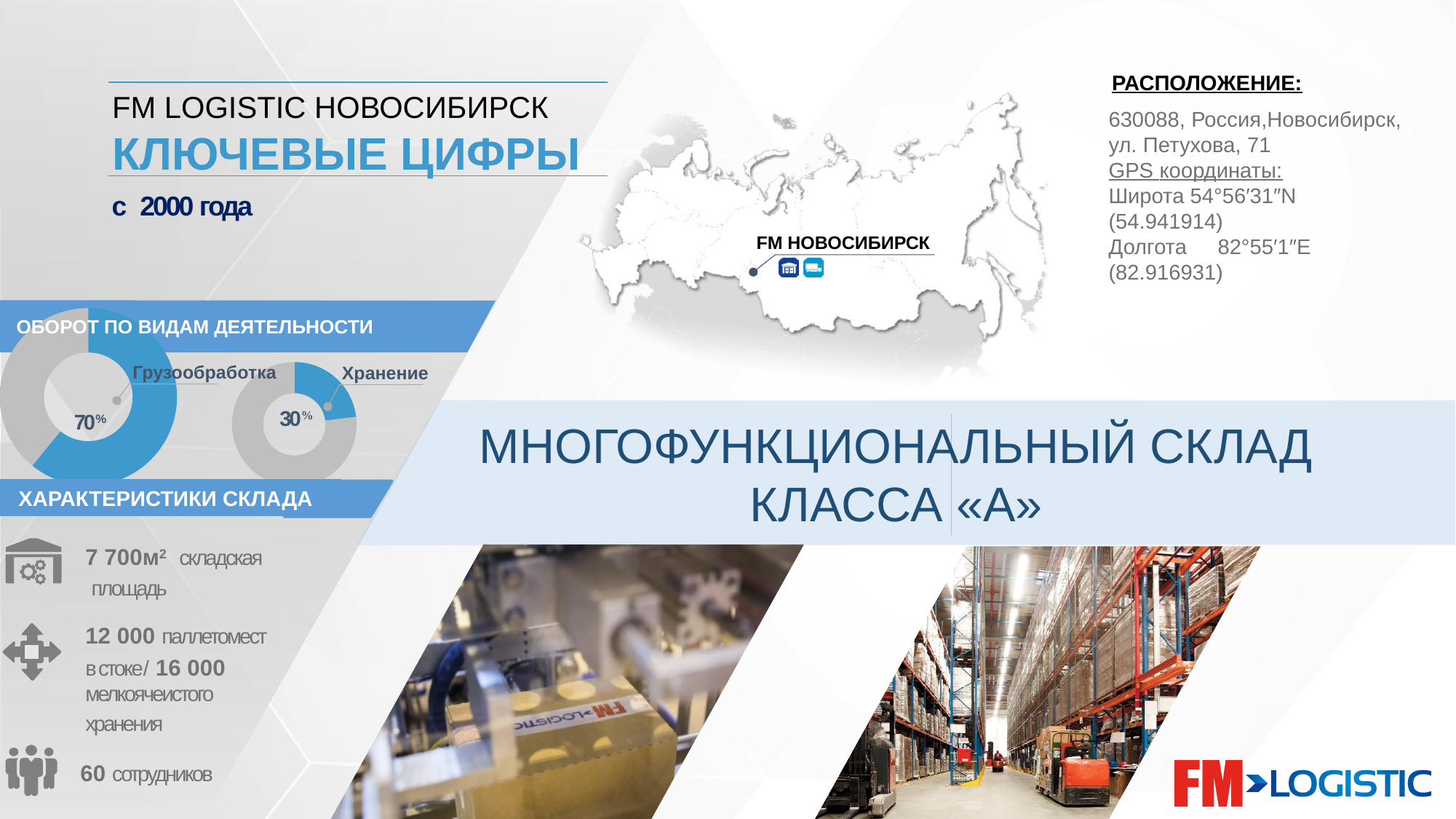
What kind of charts are used in the 'ОБОРОТ ПО ВИДАМ ДЕЯТЕЛЬНОСТИ' section? Donut (pie) charts In the 'ОБОРОТ ПО ВИДАМ ДЕЯТЕЛЬНОСТИ' section, what share is shown for Грузообработка? 70% How many donut charts are shown in the 'ОБОРОТ ПО ВИДАМ ДЕЯТЕЛЬНОСТИ' section? 2 In the 'ОБОРОТ ПО ВИДАМ ДЕЯТЕЛЬНОСТИ' section, what share is shown for Хранение? 30% In the 'ОБОРОТ ПО ВИДАМ ДЕЯТЕЛЬНОСТИ' section, which activity has the larger share, Грузообработка or Хранение? Грузообработка What is the heading above the two donut charts on the left of the slide? ОБОРОТ ПО ВИДАМ ДЕЯТЕЛЬНОСТИ In the donut charts under 'ОБОРОТ ПО ВИДАМ ДЕЯТЕЛЬНОСТИ', what colour is used for the highlighted (labelled) segment? Blue In the 'ОБОРОТ ПО ВИДАМ ДЕЯТЕЛЬНОСТИ' section, which activity has the largest share? Грузообработка In the 'ОБОРОТ ПО ВИДАМ ДЕЯТЕЛЬНОСТИ' section, which activity has the smallest share? Хранение In the 'ОБОРОТ ПО ВИДАМ ДЕЯТЕЛЬНОСТИ' section, is the share for Хранение greater or less than 50%? less In the 'ОБОРОТ ПО ВИДАМ ДЕЯТЕЛЬНОСТИ' section, what do the Грузообработка and Хранение shares add up to? 100% In the 'ОБОРОТ ПО ВИДАМ ДЕЯТЕЛЬНОСТИ' section, what is the difference in percentage points between the Грузообработка share and the Хранение share? 40